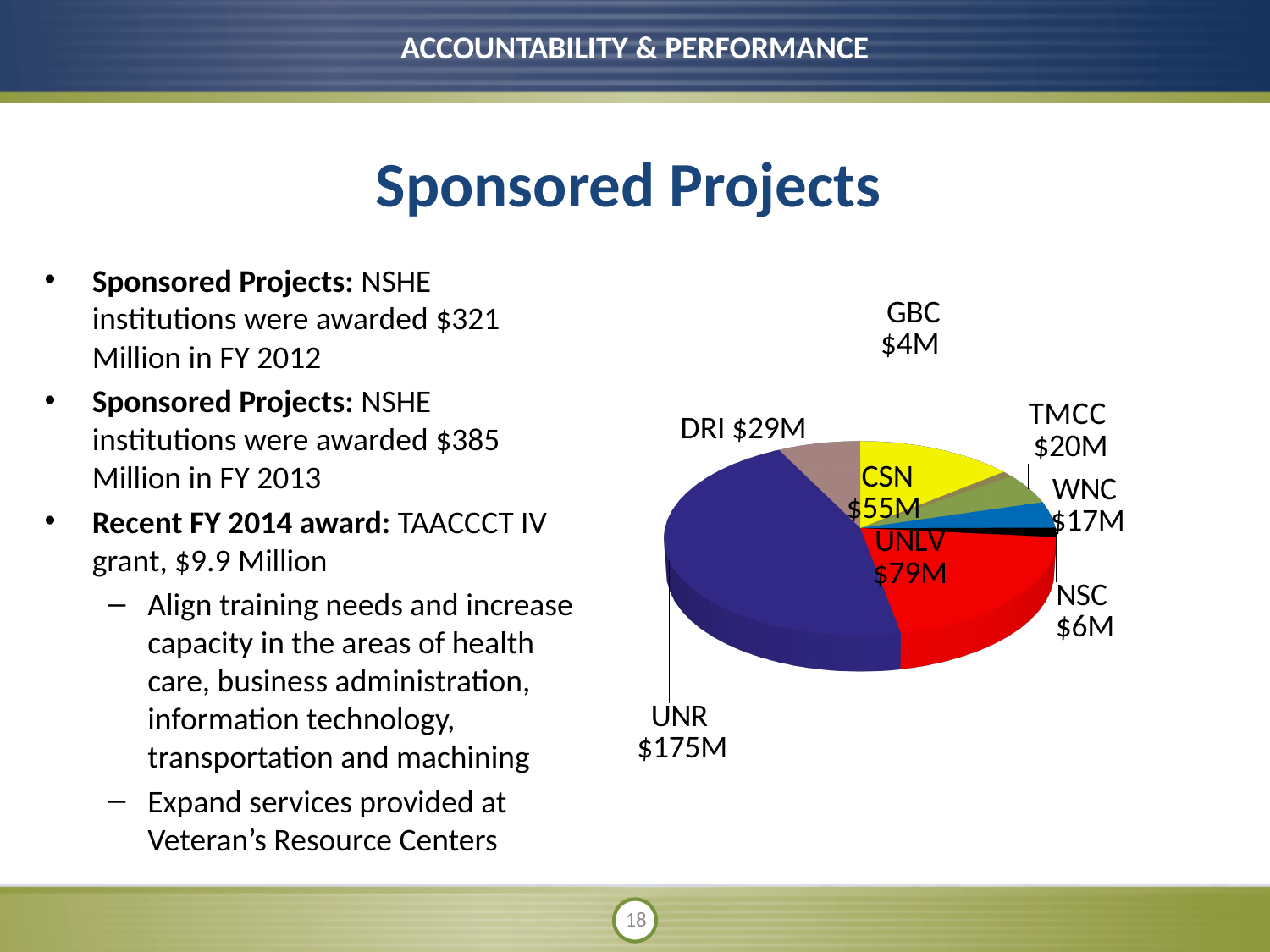
How many slices does the pie chart have? 8 Which institution has the smallest slice of the pie chart? GBC Which institution has the largest slice of the pie chart? UNR What kind of chart is shown on the slide? pie chart What is the value for DRI in the pie chart? $29M What is the value for UNR in the pie chart? $175M What colour is the UNR slice in the pie chart? dark blue What is the difference between the UNR and UNLV values in the pie chart? $96M Which is larger in the pie chart, CSN or DRI? CSN What is the total of all the slices in the pie chart? $385M What is the value for TMCC in the pie chart? $20M What is the value for UNLV in the pie chart? $79M